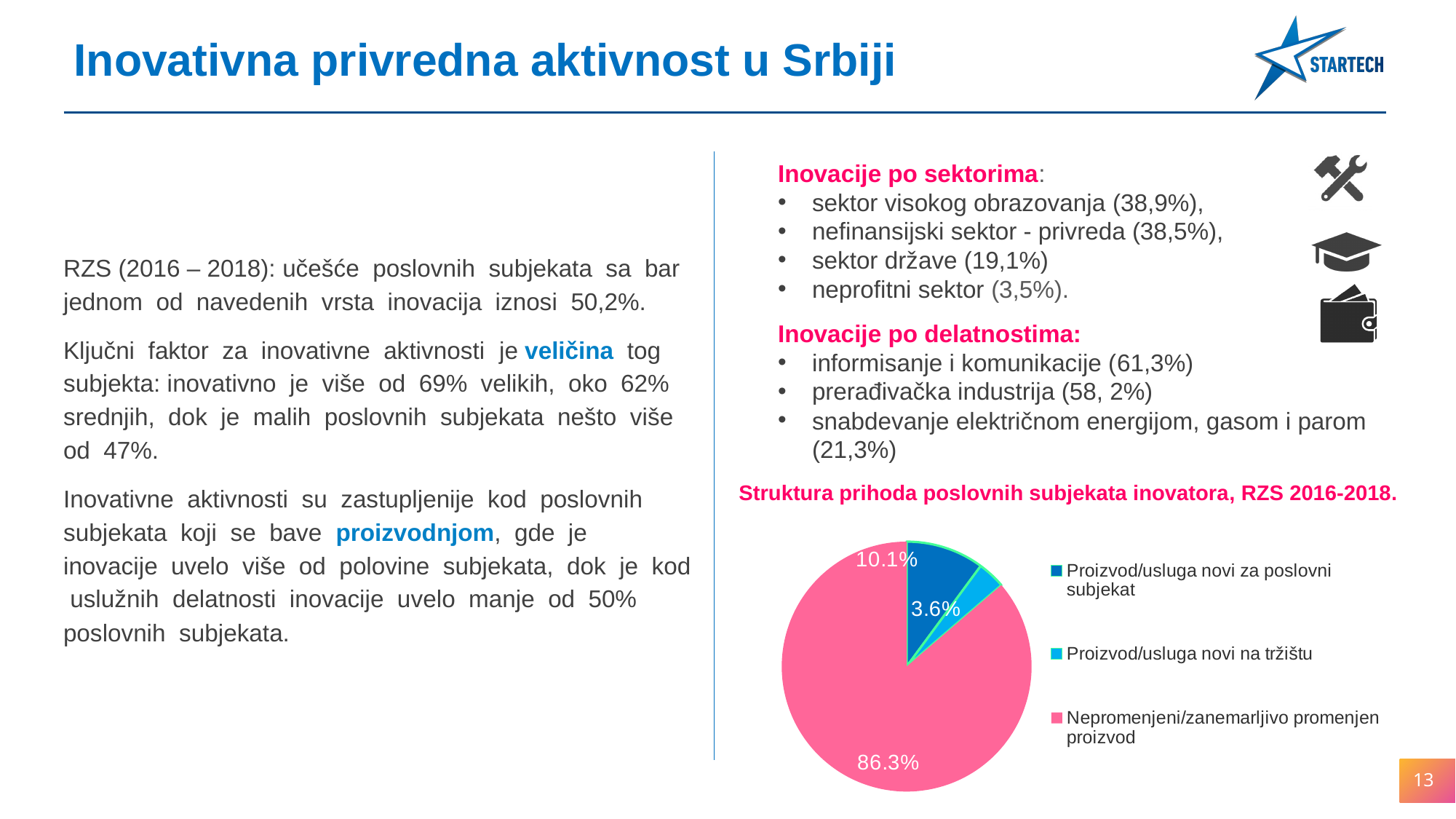
What is the title of the pie chart? Struktura prihoda poslovnih subjekata inovatora, RZS 2016-2018. What share of the pie is 'Proizvod/usluga novi na tržištu'? 3.6% How many slices does the pie chart have? 3 What colour is the 'Nepromenjeni/zanemarljivo promenjen proizvod' slice in the pie chart? pink What share of the pie is 'Proizvod/usluga novi za poslovni subjekat'? 10.1% Which category has the largest slice in the pie chart? Nepromenjeni/zanemarljivo promenjen proizvod Which is larger in the pie chart: 'Proizvod/usluga novi za poslovni subjekat' or 'Proizvod/usluga novi na tržištu'? Proizvod/usluga novi za poslovni subjekat Which category has the smallest slice in the pie chart? Proizvod/usluga novi na tržištu What share of the pie is 'Nepromenjeni/zanemarljivo promenjen proizvod'? 86.3% What kind of chart is shown on the slide? pie chart What is the difference in percentage points between the 'Nepromenjeni/zanemarljivo promenjen proizvod' slice and the 'Proizvod/usluga novi za poslovni subjekat' slice? 76.2 How many entries does the pie chart legend list? 3